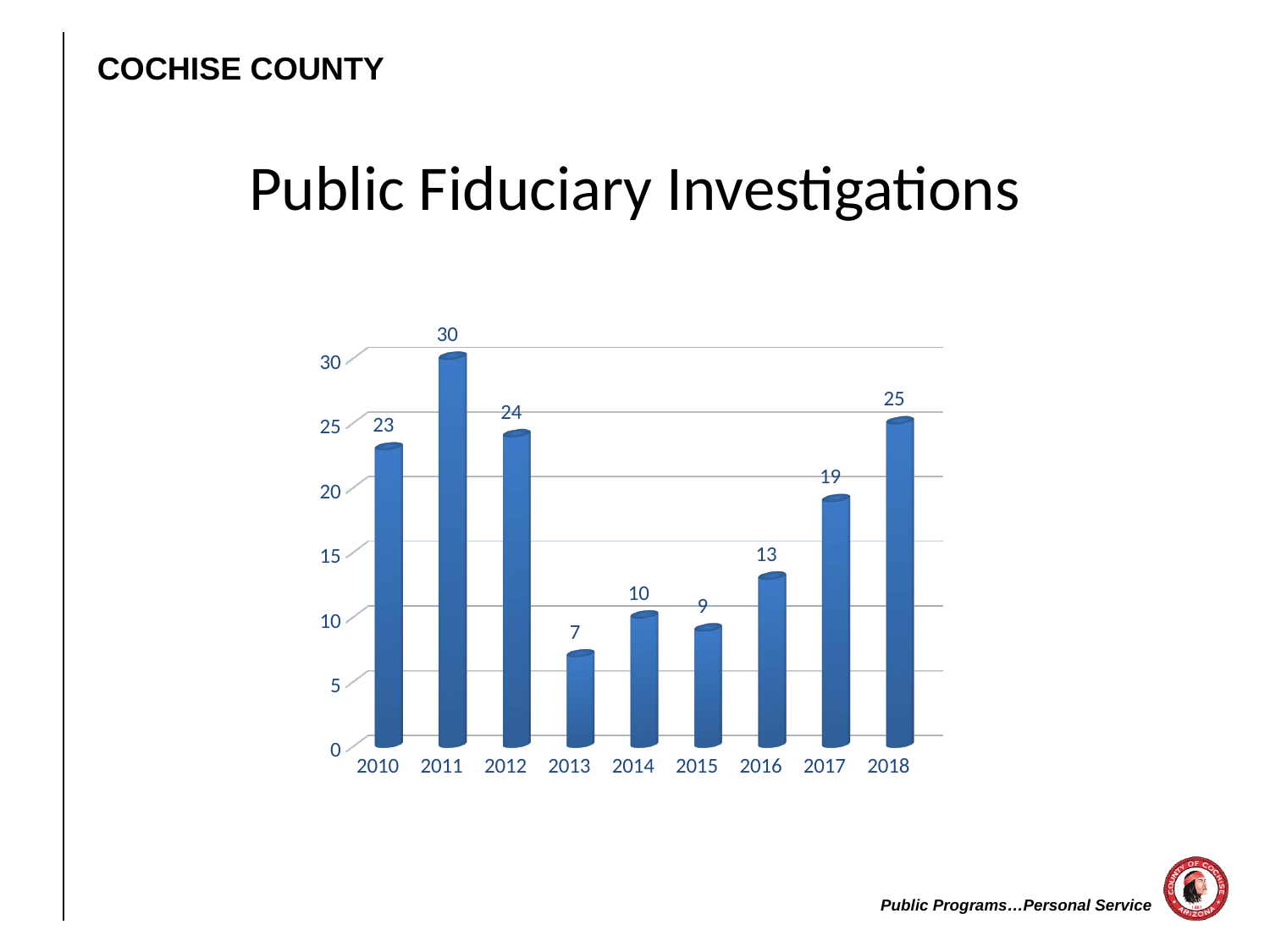
Which year has the highest value? 2011 Is the value for 2014 greater or less than 15? less What is the difference between the values for 2018 and 2016? 12 What is the title of the chart? Public Fiduciary Investigations What is the value for 2017? 19 Which is larger, the value for 2010 or the value for 2012? 2012 What is the value for 2013? 7 How many years are shown on the x axis? 9 What kind of chart is shown on the slide? bar chart What is the value for 2011? 30 Which year has the lowest value? 2013